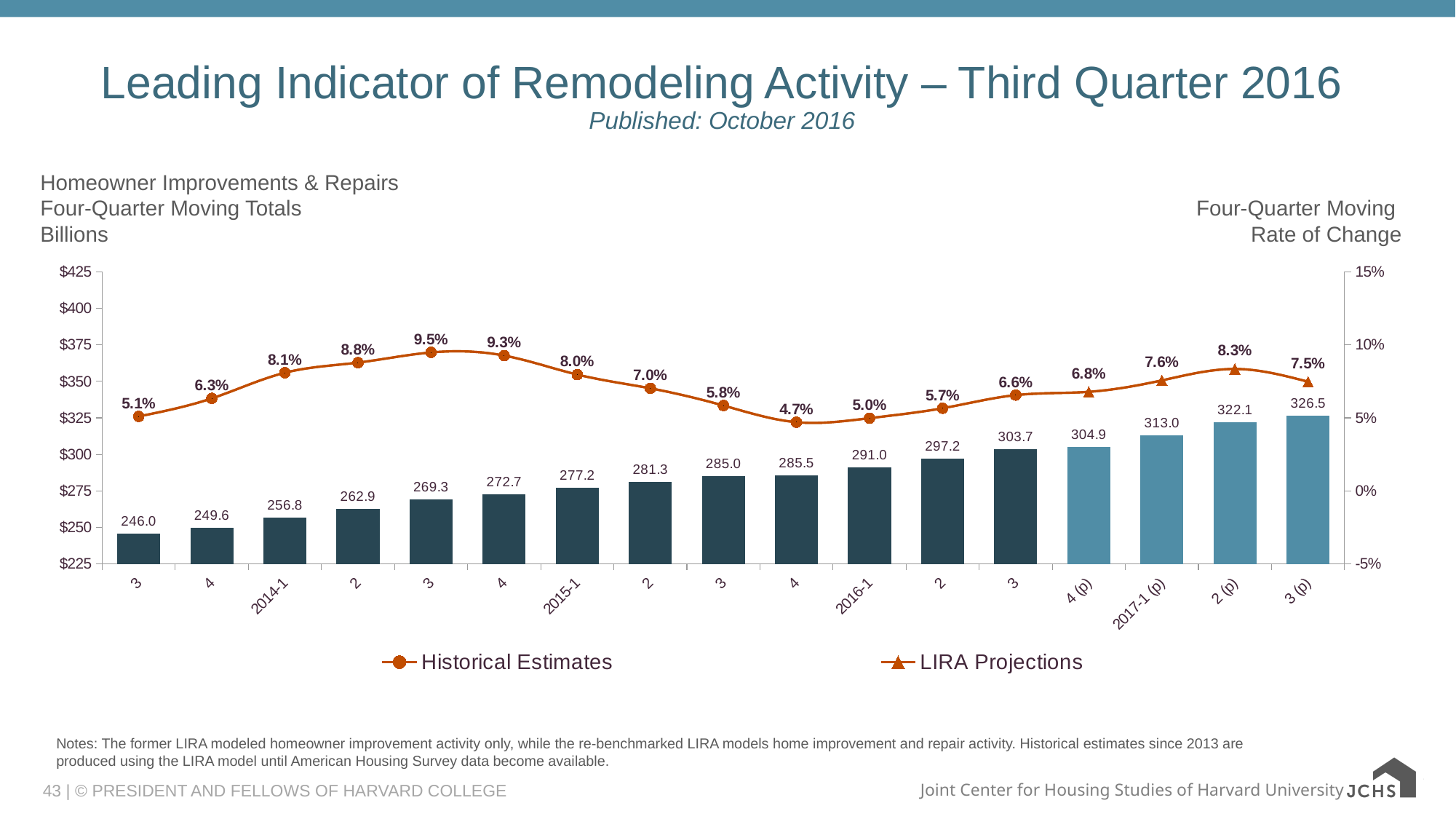
What is the four-quarter moving rate of change for 2015-1? 8.0% What is the lowest four-quarter moving rate of change shown on the line? 4.7% What is the four-quarter moving rate of change for 2016-1? 5.0% What is the four-quarter moving total (in billions) for 2014-1? 256.8 How many periods are shown on the x axis? 17 What is the four-quarter moving total (in billions) for 2017-1 (p)? 313.0 How many series does the legend list? 2 What is the highest four-quarter moving rate of change shown on the line? 9.5% Which period has the highest four-quarter moving total? 3 (p) What is the difference in four-quarter moving totals between 3 (p) and 2017-1 (p)? 13.5 Which has a higher four-quarter moving rate of change, 2015-1 or 2016-1? 2015-1 What are the two legend entries? Historical Estimates and LIRA Projections